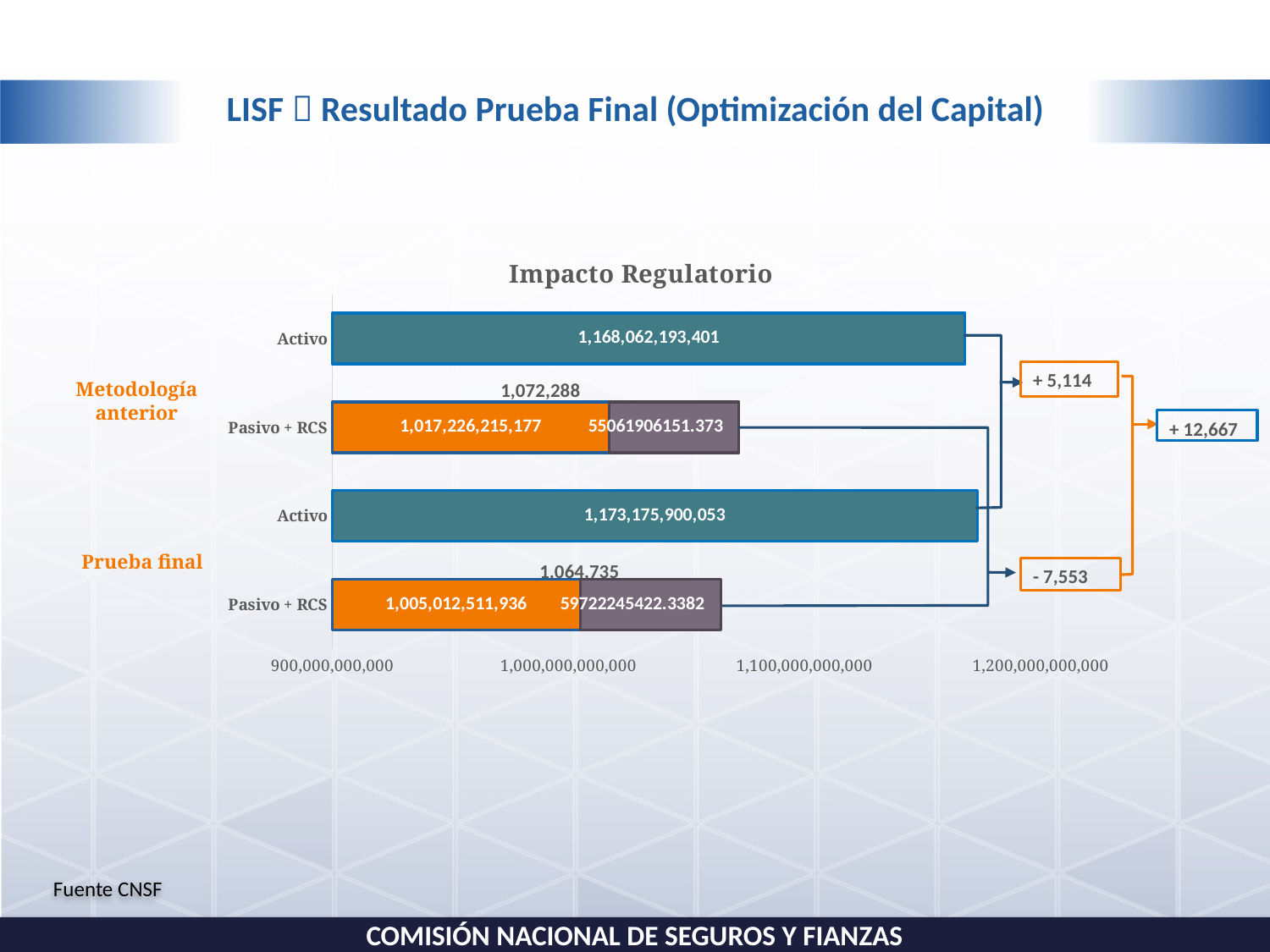
What is the title of the chart? Impacto Regulatorio What is the value of the orange segment of the Pasivo + RCS bar under Prueba final? 1,005,012,511,936 What is the difference between the Activo value under Prueba final and the Activo value under Metodología anterior? 5,113,706,652 How many bars are plotted in the chart? 4 What is the value of the Activo bar under Prueba final? 1,173,175,900,053 What type of chart is shown on the slide? bar chart Is the Activo value under Metodología anterior greater or less than 1,100,000,000,000? greater Which Activo bar is larger, Metodología anterior or Prueba final? Prueba final What is the value of the Activo bar under Metodología anterior? 1,168,062,193,401 What total is printed above the Pasivo + RCS bar under Prueba final? 1,064,735 What value is shown in the rightmost annotation box next to the chart? + 12,667 What is the value of the orange segment of the Pasivo + RCS bar under Metodología anterior? 1,017,226,215,177